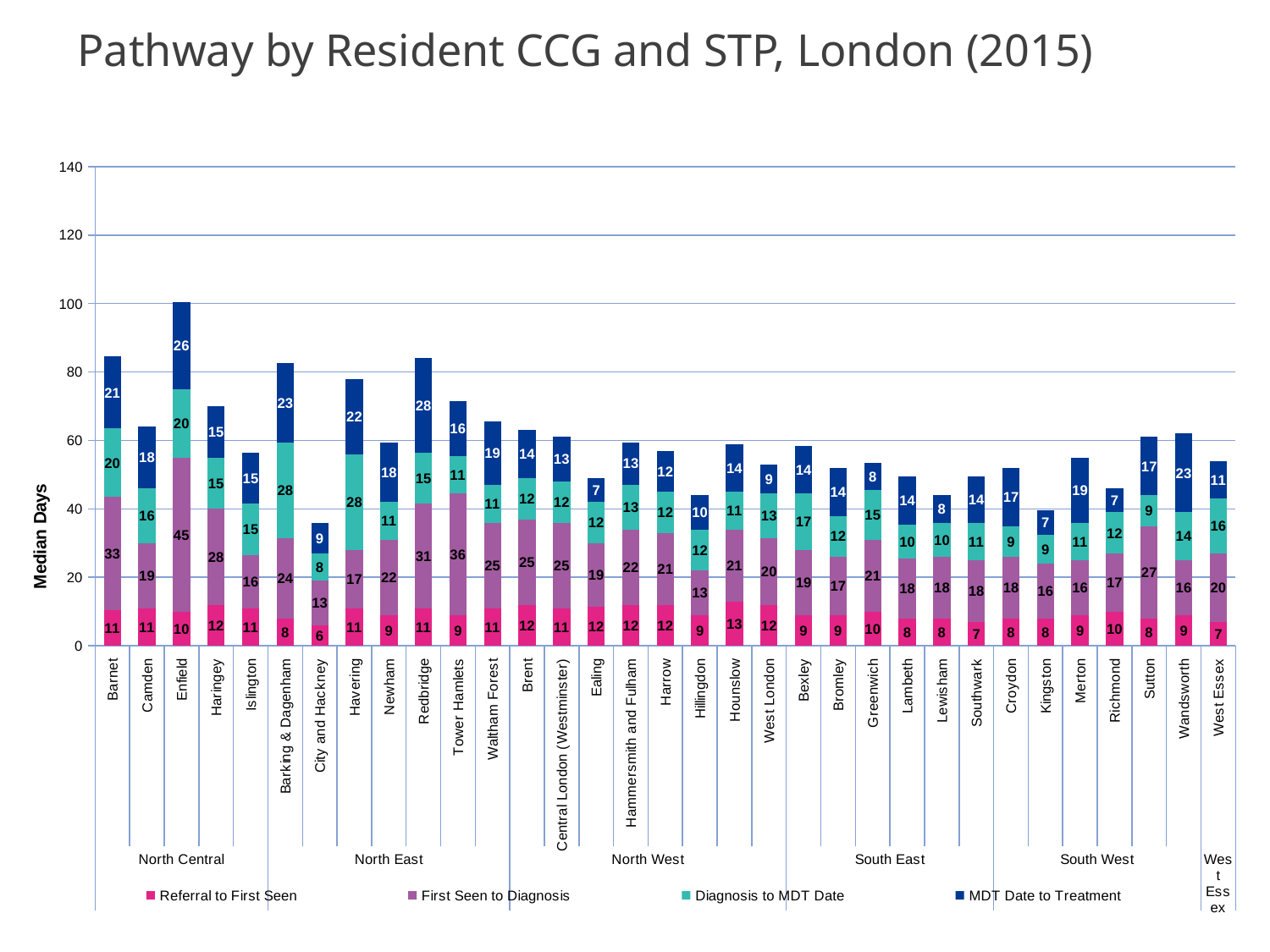
What is the First Seen to Diagnosis value for Enfield? 45 How many series does the legend list? 4 What type of chart is shown on the slide? Stacked bar chart Which CCG has the highest total median days across the whole pathway? Enfield What is the Diagnosis to MDT Date value for Barking & Dagenham? 28 Which is larger, the MDT Date to Treatment value for Wandsworth or for Sutton? Wandsworth What is the total median days for the City and Hackney bar? 36 Which CCG has the lowest total median days across the whole pathway? City and Hackney What is the total median days for the Enfield bar? 101 What is the MDT Date to Treatment value for Redbridge? 28 What is the Referral to First Seen value for Hounslow? 13 What is the difference between the First Seen to Diagnosis values for Tower Hamlets and Camden? 17